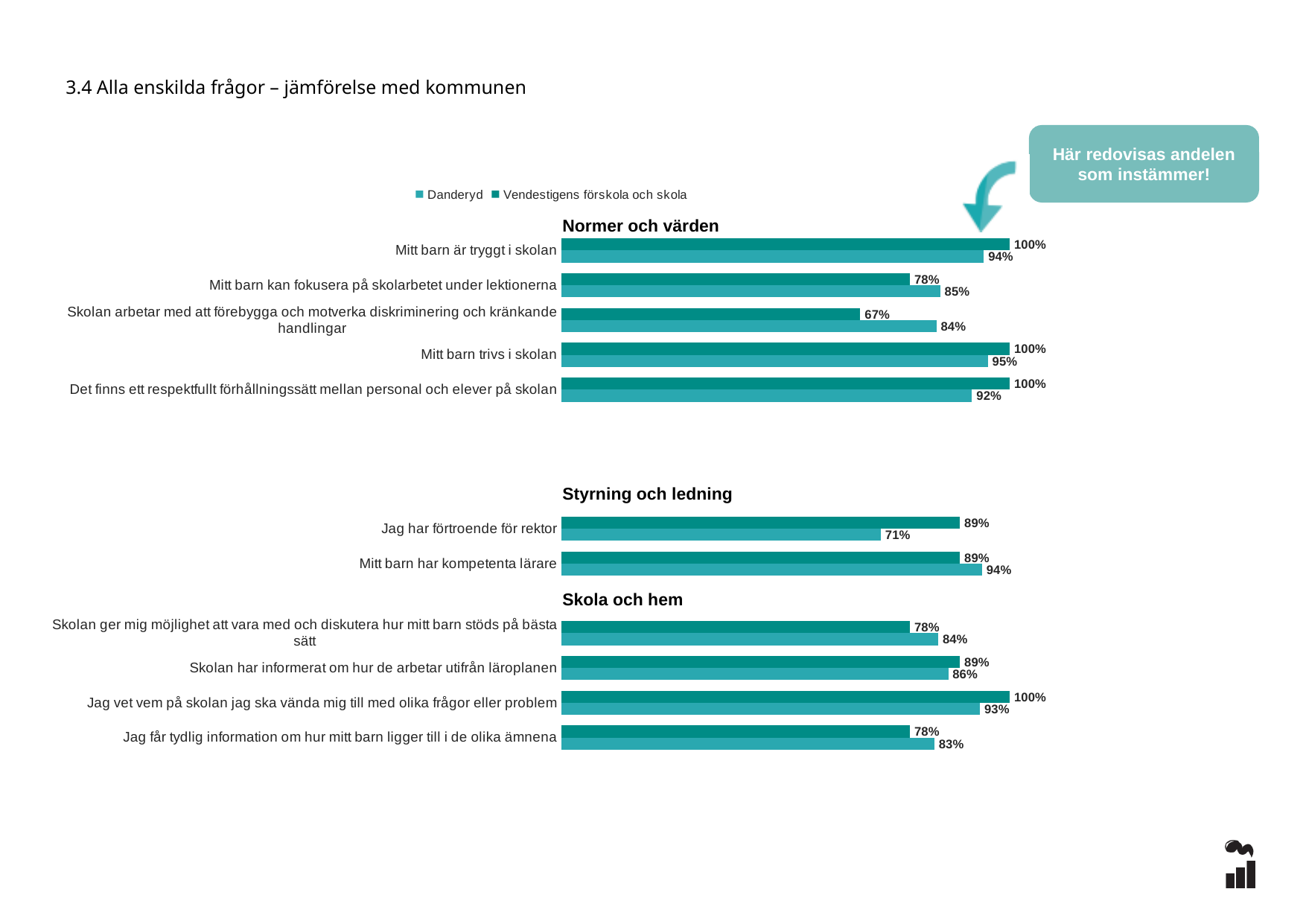
What is the value for Vendestigens förskola och skola for "Skolan arbetar med att förebygga och motverka diskriminering och kränkande handlingar"? 67% For "Mitt barn har kompetenta lärare", which is larger: Danderyd or Vendestigens förskola och skola? Danderyd How many questions (categories) are plotted in the chart in total? 11 What is the value for Danderyd for "Mitt barn kan fokusera på skolarbetet under lektionerna"? 85% How many series does the legend list? 2 What kind of chart is shown on the slide? bar chart Which question has the lowest value for Vendestigens förskola och skola? Skolan arbetar med att förebygga och motverka diskriminering och kränkande handlingar What is the difference between Vendestigens förskola och skola and Danderyd for "Jag har förtroende för rektor"? 18% What is the value for Vendestigens förskola och skola for "Mitt barn är tryggt i skolan"? 100% What are the three section headings shown in the chart? Normer och värden, Styrning och ledning, Skola och hem Which question has the lowest value for Danderyd? Jag har förtroende för rektor What is the value for Danderyd for "Jag har förtroende för rektor"? 71%